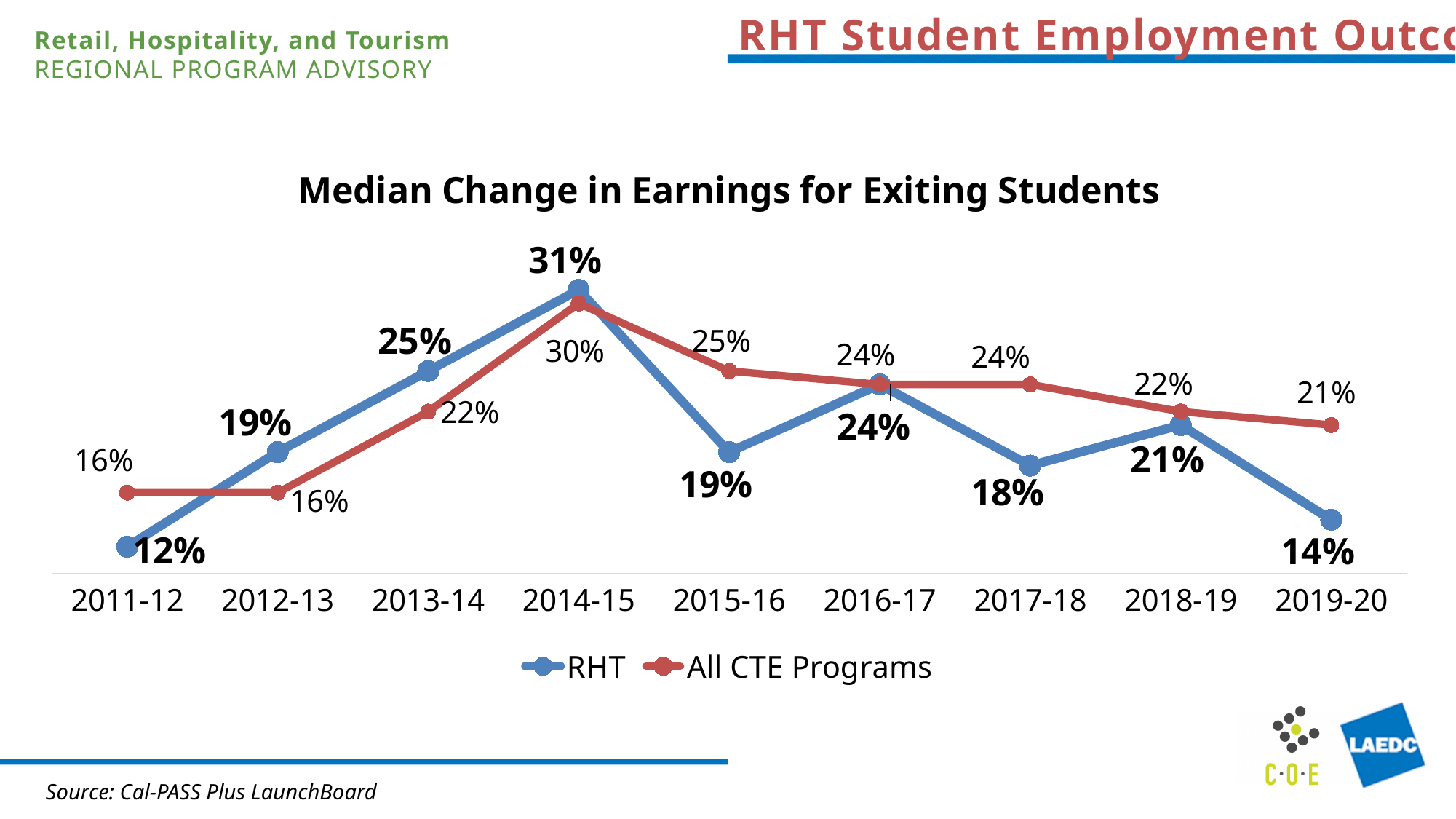
Which series has the larger value in 2015-16, RHT or All CTE Programs? All CTE Programs What type of chart is shown on the slide? Line chart What is the All CTE Programs value for 2019-20? 21% How many years are shown on the x axis? 9 Does the All CTE Programs value rise or fall from 2015-16 to 2019-20? Fall What is the RHT value for 2014-15? 31% What is the RHT value for 2017-18? 18% In which year is the RHT value highest? 2014-15 What is the title of the chart? Median Change in Earnings for Exiting Students How many series does the legend list? 2 What is the difference between the RHT value and the All CTE Programs value in 2019-20? 7% In which year is the RHT value lowest? 2011-12